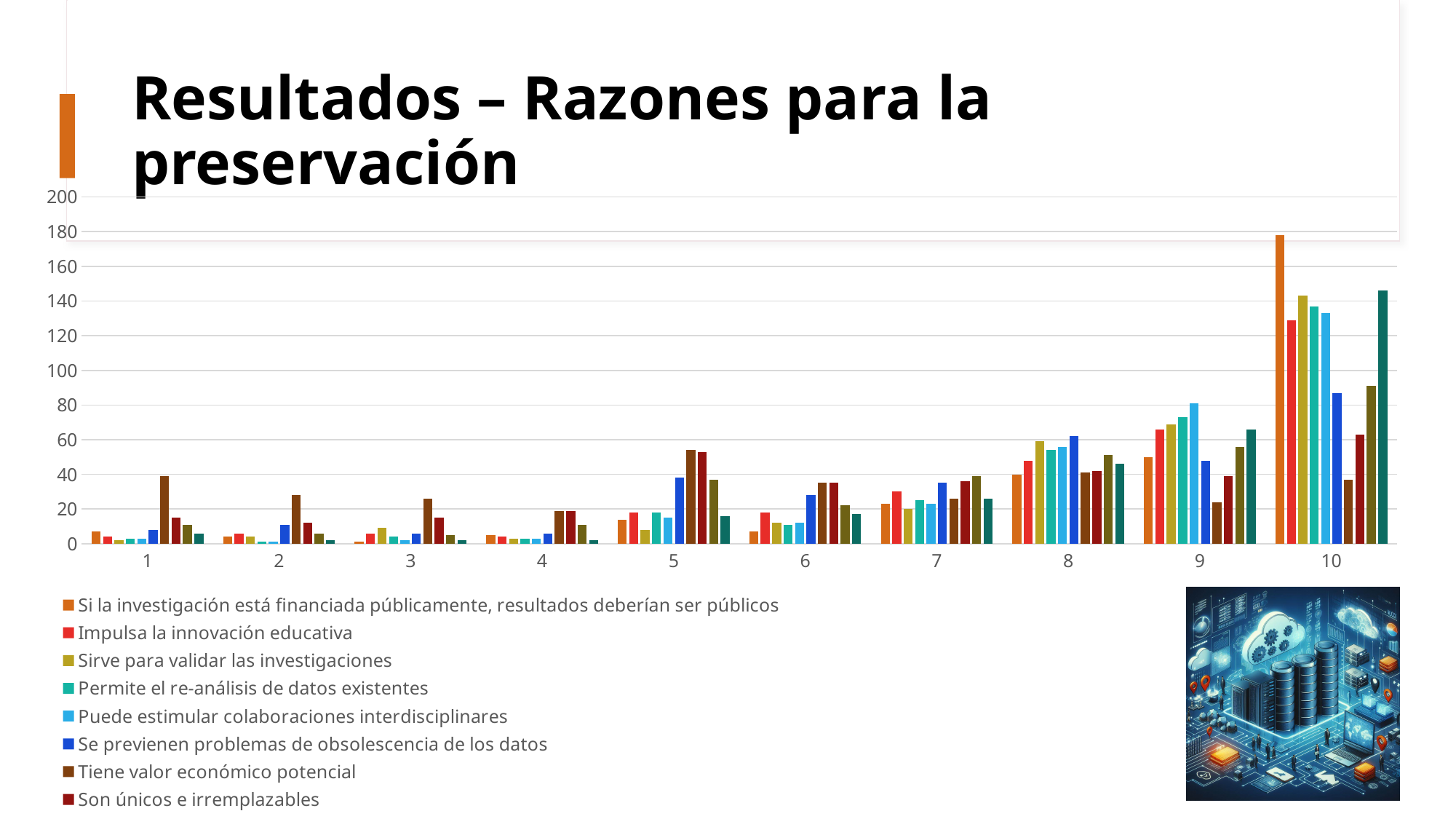
Is the value for 'Tiene valor económico potencial' in category 5 greater or less than 40? greater Is the value for 'Tiene valor económico potencial' in category 1 greater or less than 20? greater How many categories are shown along the x axis? 10 Which series has the tallest bar in category 10? Si la investigación está financiada públicamente, resultados deberían ser públicos What is the title of the slide containing the chart? Resultados – Razones para la preservación Do the values generally rise or fall from category 1 to category 10? rise Is the value for 'Si la investigación está financiada públicamente, resultados deberían ser públicos' in category 10 greater or less than 160? greater Which category has the tallest bar in the chart? 10 What kind of chart is shown on the slide? bar chart How many series does the legend list? 8 In category 10, which is larger: the value for 'Si la investigación está financiada públicamente, resultados deberían ser públicos' or the value for 'Impulsa la innovación educativa'? Si la investigación está financiada públicamente, resultados deberían ser públicos